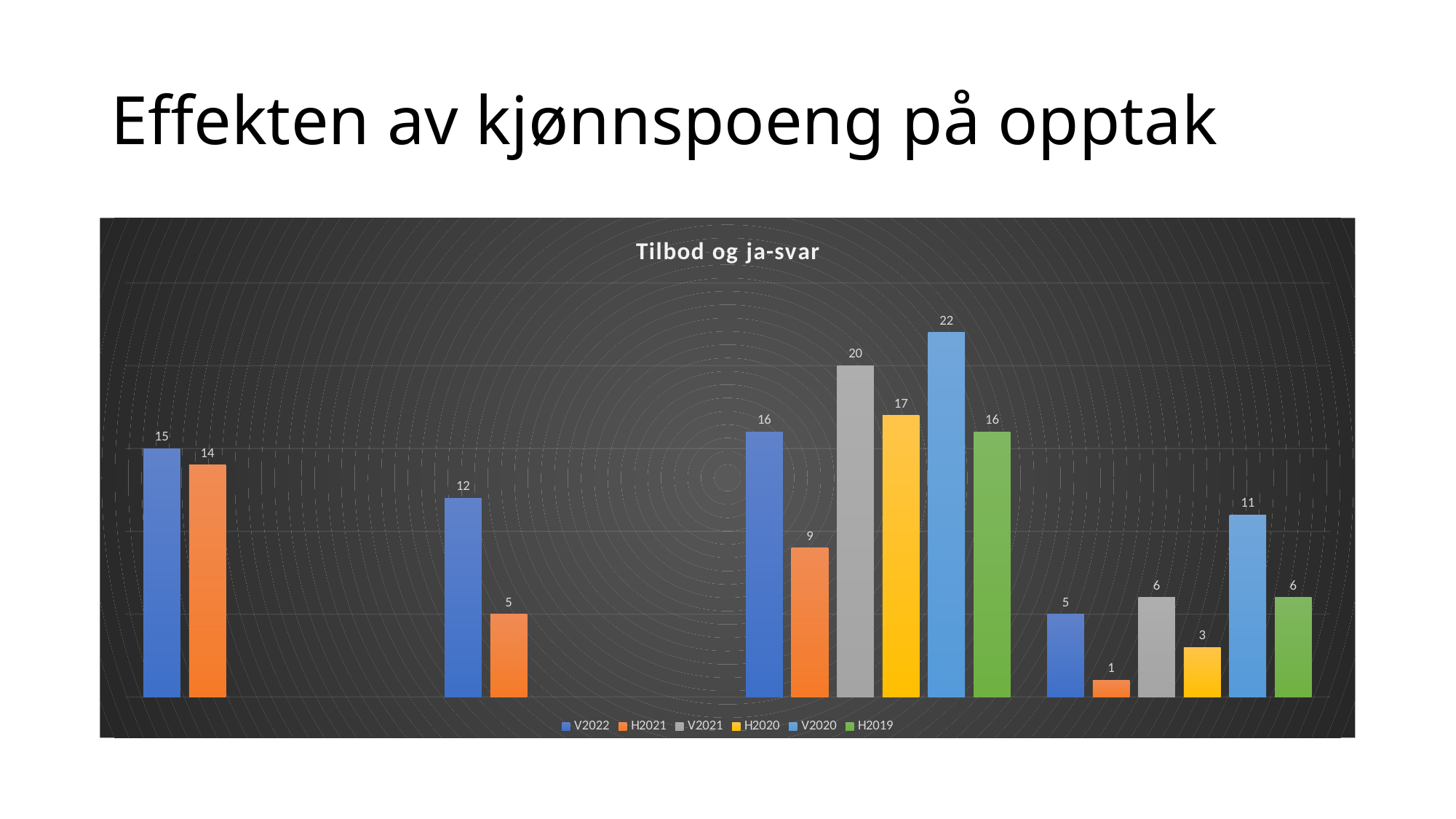
In the third group of bars from the left, which is larger: the V2021 bar or the H2020 bar? V2021 What is the value of the H2020 bar in the fourth group of bars from the left? 3 Which series has the lowest value in the fourth group of bars from the left? H2021 What is the title of the chart? Tilbod og ja-svar What is the difference between the V2022 and H2021 bars in the second group of bars from the left? 7 What is the value of the V2020 bar in the third group of bars from the left? 22 Which series has the highest value in the third group of bars from the left? V2020 What is the highest value shown anywhere on the chart? 22 What is the difference between the V2020 bars in the third and fourth groups of bars from the left? 11 What is the value of the H2021 bar in the first group of bars from the left? 14 What kind of chart is shown on the slide? bar chart How many series does the legend list? 6